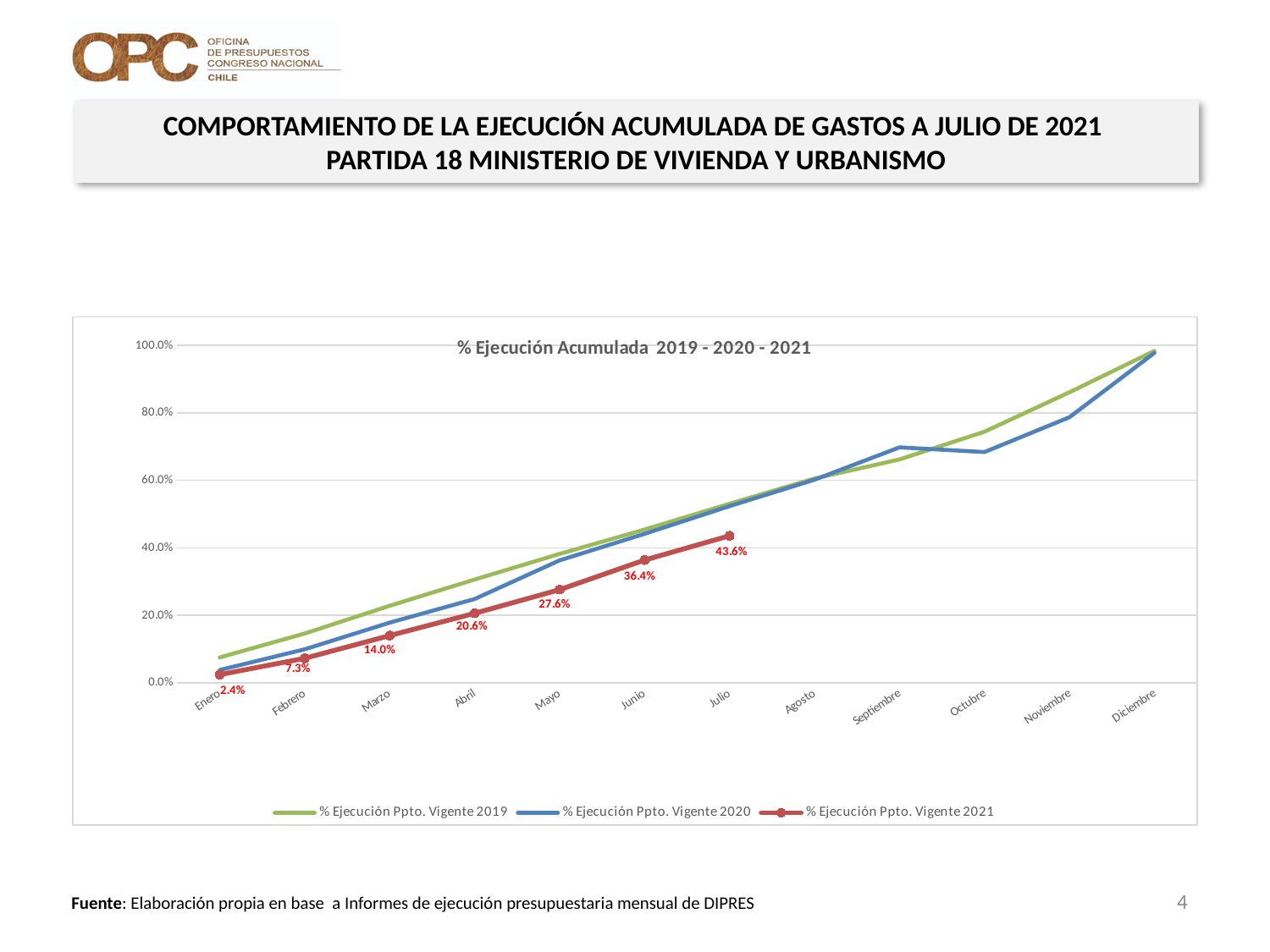
What is the value for Abril in the % Ejecución Ppto. Vigente 2021 series? 20.6% Do the values of the % Ejecución Ppto. Vigente 2021 series rise or fall from Enero to Julio? Rise In Marzo, which series has the larger value: % Ejecución Ppto. Vigente 2019 or % Ejecución Ppto. Vigente 2020? % Ejecución Ppto. Vigente 2019 What kind of chart is shown? Line chart Which month has the highest value in the % Ejecución Ppto. Vigente 2021 series? Julio How many months are shown on the x axis? 12 Is the value for Septiembre in the % Ejecución Ppto. Vigente 2020 series greater or less than 60.0%? greater Which month has the lowest value in the % Ejecución Ppto. Vigente 2021 series? Enero How many series does the legend list? 3 What is the value for Enero in the % Ejecución Ppto. Vigente 2021 series? 2.4% What is the value for Julio in the % Ejecución Ppto. Vigente 2021 series? 43.6% What is the difference between the Julio and Junio values in the % Ejecución Ppto. Vigente 2021 series? 7.2%